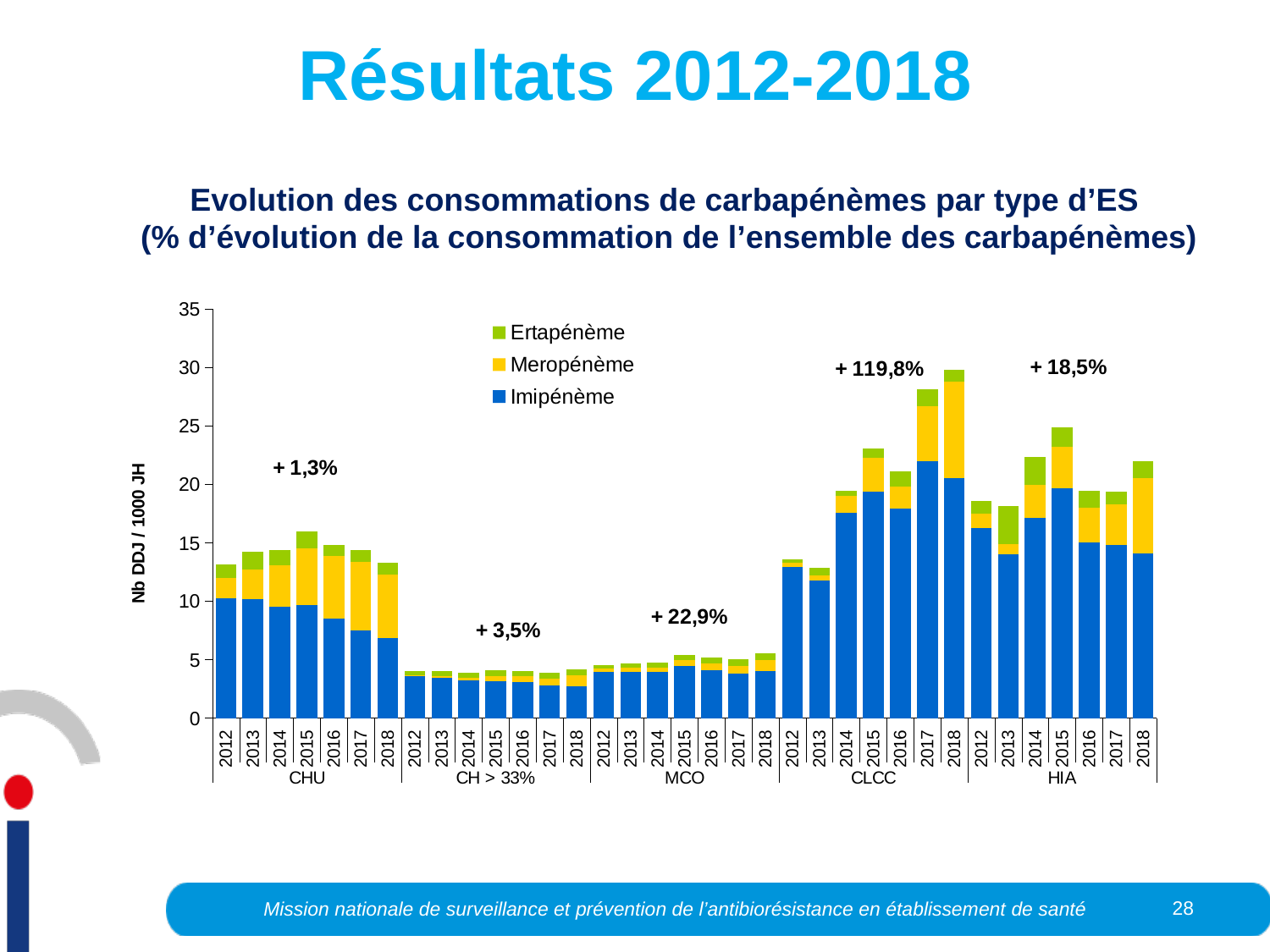
Does the Imipénème value for CHU rise or fall from 2012 to 2018? fall How many establishment types (groups) are shown on the x axis? 5 What percentage change is printed above the CLCC group? + 119,8% Is the total value for CH > 33% in 2012 greater or less than 5? less Which establishment type has the lowest carbapenem consumption bars? CH > 33% Which three carbapenems are listed in the legend? Ertapénème, Meropénème, Imipénème How many series does the legend list? 3 What percentage change is printed above the MCO group? + 22,9% What kind of chart is shown on the slide? Stacked bar chart Is the total value for CLCC in 2017 greater or less than 25? greater What percentage change is printed above the CHU group? + 1,3% Which establishment type has the highest carbapenem consumption bars? CLCC